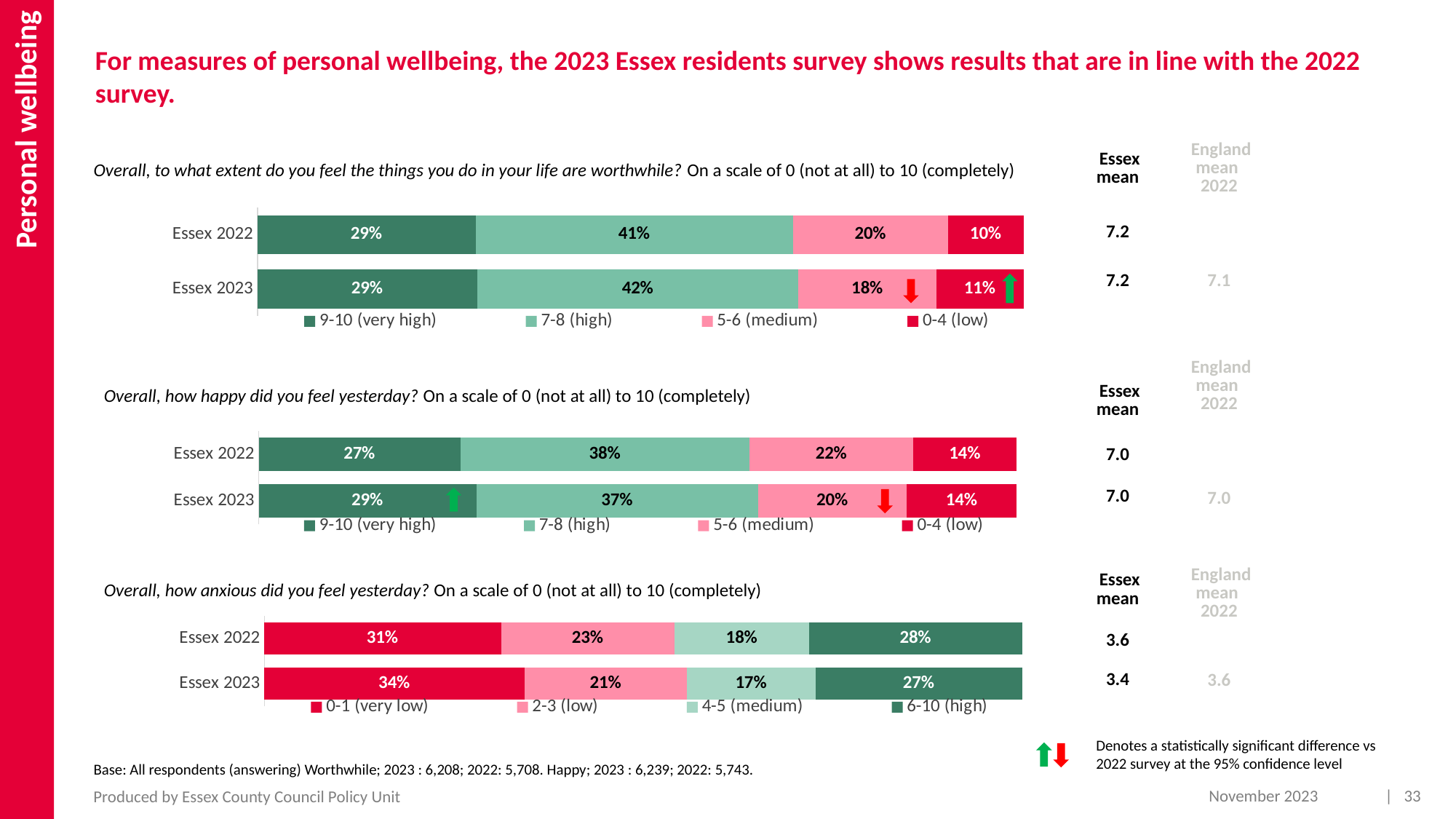
In the 'how anxious' chart, what is the combined share of the 0-1 (very low) and 2-3 (low) bands for Essex 2023? 55% In the 'how anxious' chart, which rating band has the largest share for Essex 2022? 0-1 (very low) In the 'worthwhile' chart, what is the difference between the 5-6 (medium) share for Essex 2022 and Essex 2023? 2 percentage points In the 'worthwhile' chart, what percentage of Essex 2022 respondents gave a 0-4 (low) rating? 10% How many series does the legend list in the 'how happy' chart? 4 In the 'how anxious' chart, is the 0-1 (very low) share larger for Essex 2022 or Essex 2023? Essex 2023 In the 'how anxious' chart, what percentage of Essex 2023 respondents gave a 0-1 (very low) rating? 34% In the 'how happy' chart, what percentage of Essex 2023 respondents gave a 9-10 (very high) rating? 29% In the 'worthwhile' chart, what percentage of Essex 2023 respondents gave a 7-8 (high) rating? 42% What type of chart is used for the 'worthwhile' question? Stacked bar chart What is the Essex mean for the 'how anxious' question in 2023? 3.4 In the 'how happy' chart, which rating band has the smallest share for Essex 2022? 0-4 (low)